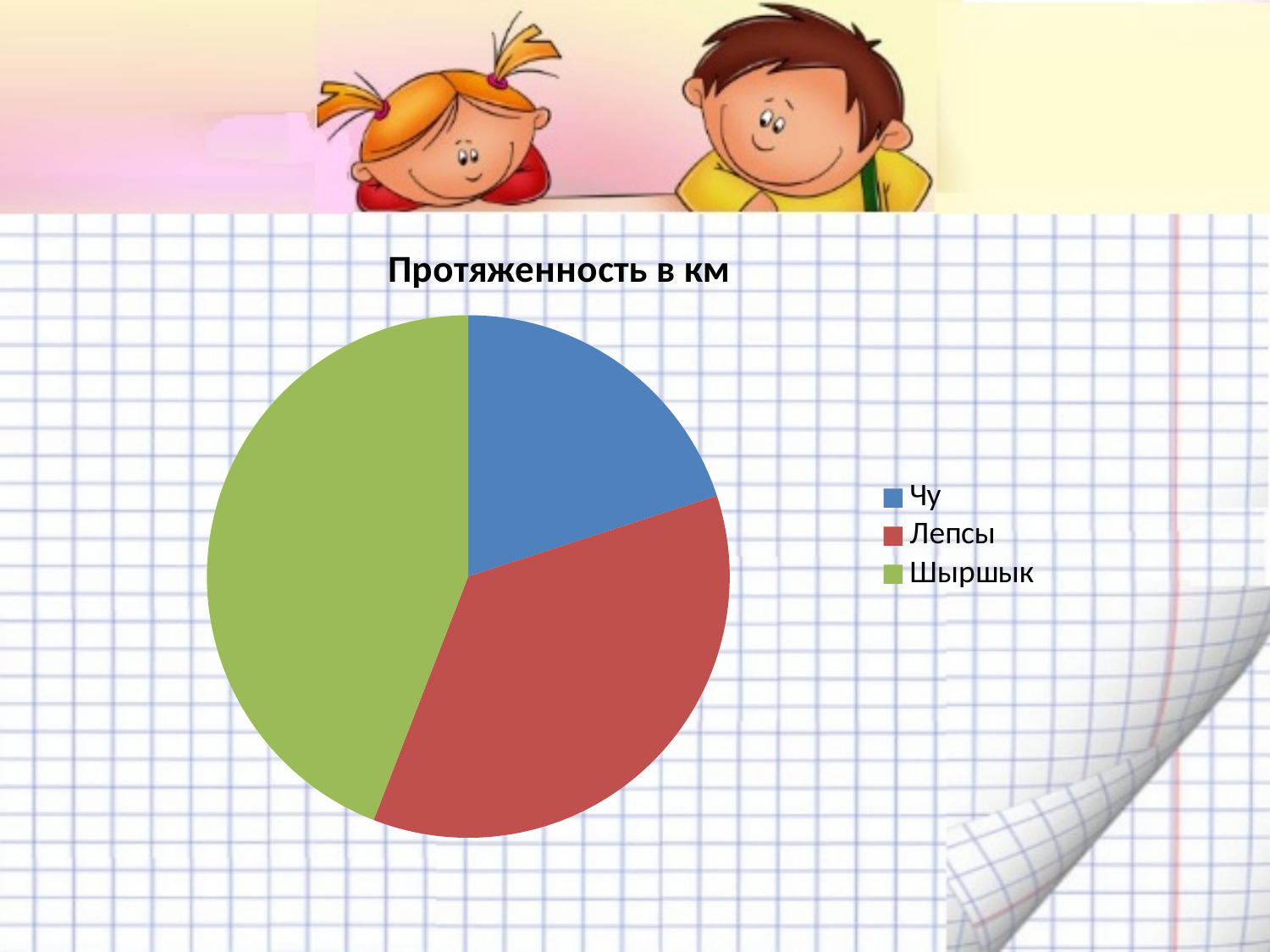
Which category has the largest slice of the pie? Шыршык What colour is the slice for Шыршык? green Which category is shown in blue? Чу Which category has the smallest slice of the pie? Чу How many entries does the legend list? 3 How many slices does the pie chart have? 3 What kind of chart is shown on the slide? pie chart What is the title of the chart? Протяженность в км Which slice is larger, Чу or Лепсы? Лепсы Which slice is larger, Чу or Шыршык? Шыршык